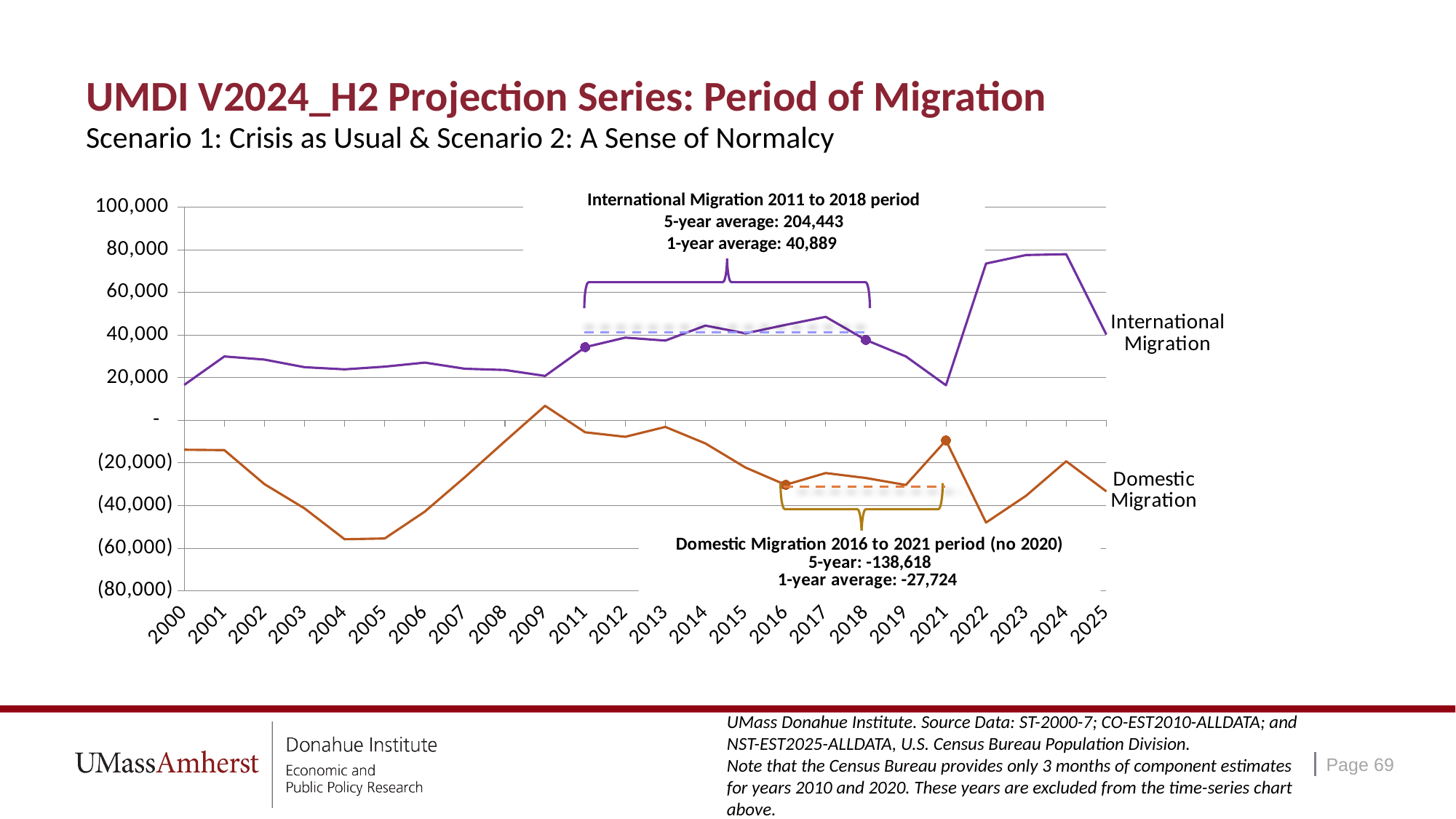
Which is larger, International Migration in 2021 or in 2022? 2022 Is the value for Domestic Migration in 2022 greater or less than (40,000)? less Does Domestic Migration rise or fall from 2000 to 2004? fall How many series are plotted on the chart? 2 Is the value for International Migration in 2022 greater or less than 60,000? greater According to the annotation, what is the 5-year average for International Migration in the 2011 to 2018 period? 204,443 How many years are shown on the x axis of the chart? 24 Is the value for International Migration in 2009 greater or less than 40,000? less Which year has the highest value for Domestic Migration? 2009 What kind of chart is shown on the slide? Line chart Which is larger, Domestic Migration in 2004 or in 2009? 2009 According to the annotation, what is the 1-year average for Domestic Migration in the 2016 to 2021 period? -27,724